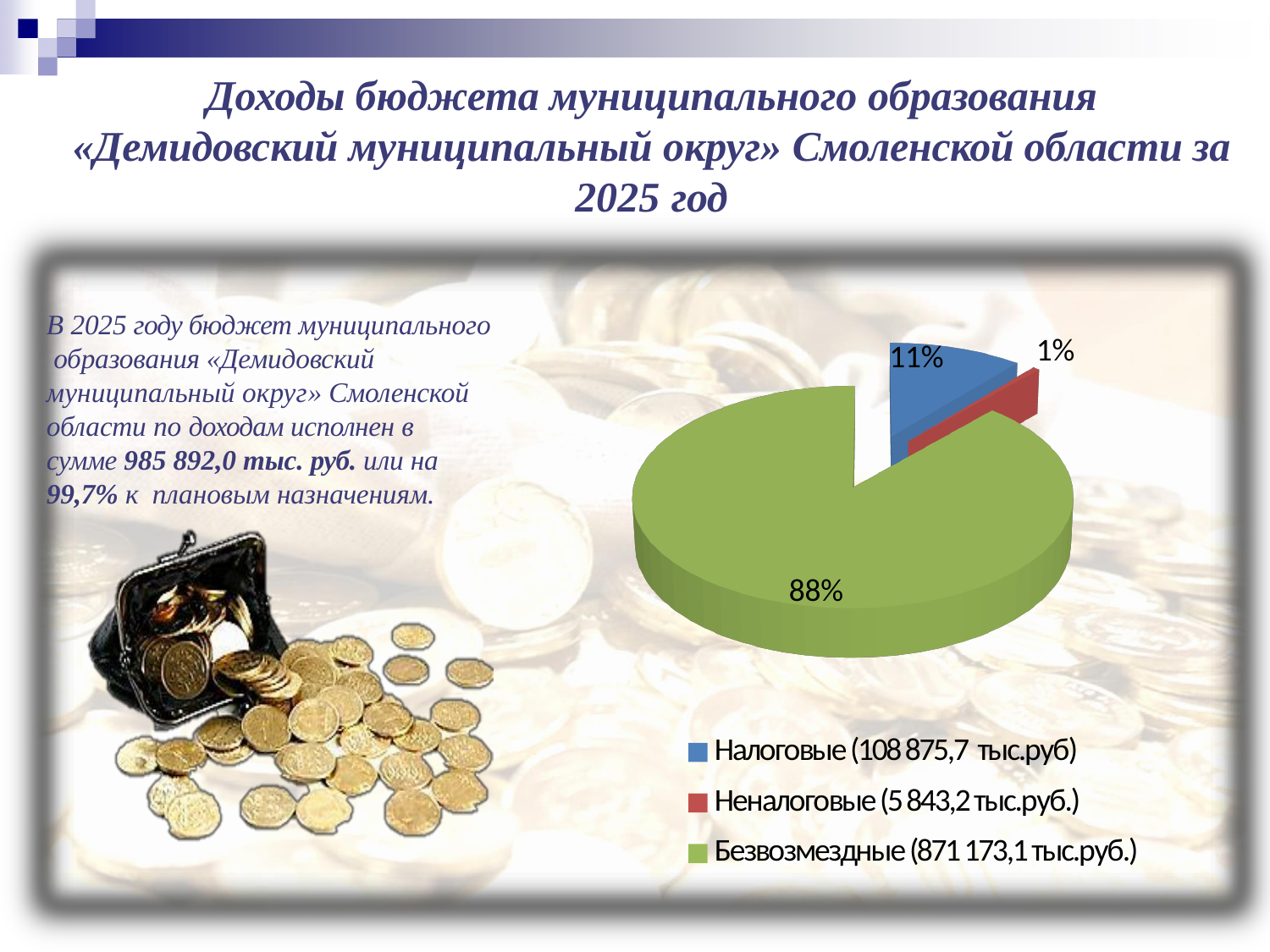
How many entries does the legend list? 3 What share of the pie does the Налоговые slice represent? 11% What type of chart is shown on the slide? pie chart How many slices does the pie chart have? 3 What share of the pie does the Неналоговые slice represent? 1% What share of the pie does the Безвозмездные slice represent? 88% Which category has the smallest slice of the pie? Неналоговые Which category has the largest slice of the pie? Безвозмездные By how many percentage points does the Безвозмездные share exceed the Налоговые share? 77 percentage points Which is larger, the Налоговые slice or the Неналоговые slice? Налоговые What amount in тыс.руб. is given in the legend for Безвозмездные? 871 173,1 тыс.руб. What amount in тыс.руб. is given in the legend for Налоговые? 108 875,7 тыс.руб